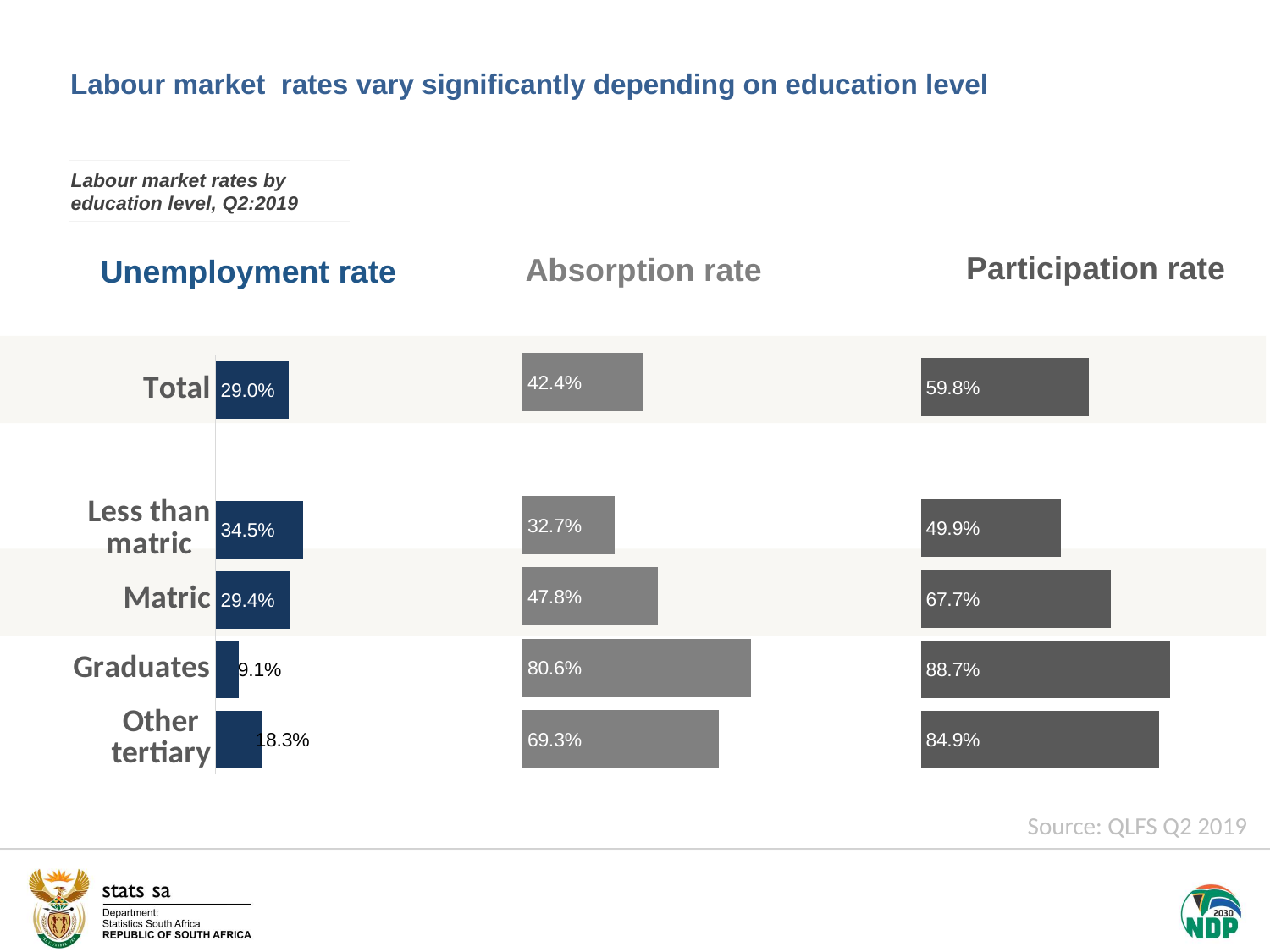
In the Absorption rate chart, which category has the lowest value? Less than matric In the Unemployment rate chart, what is the difference between the values for Less than matric and Graduates? 25.4 percentage points What is the title of the chart group shown on the slide? Labour market rates by education level, Q2:2019 In the Absorption rate chart, which is larger, the value for Graduates or the value for Other tertiary? Graduates In the Unemployment rate chart, which category has the highest value? Less than matric How many categories are shown in the Unemployment rate chart? 5 What kind of chart is the Absorption rate chart? Bar chart In the Absorption rate chart, what is the value for Matric? 47.8% In the Participation rate chart, what is the value for Other tertiary? 84.9% In the Participation rate chart, which category has the highest value? Graduates In the Unemployment rate chart, what is the value for Graduates? 9.1% In the Participation rate chart, what is the difference between the values for Matric and Total? 7.9 percentage points